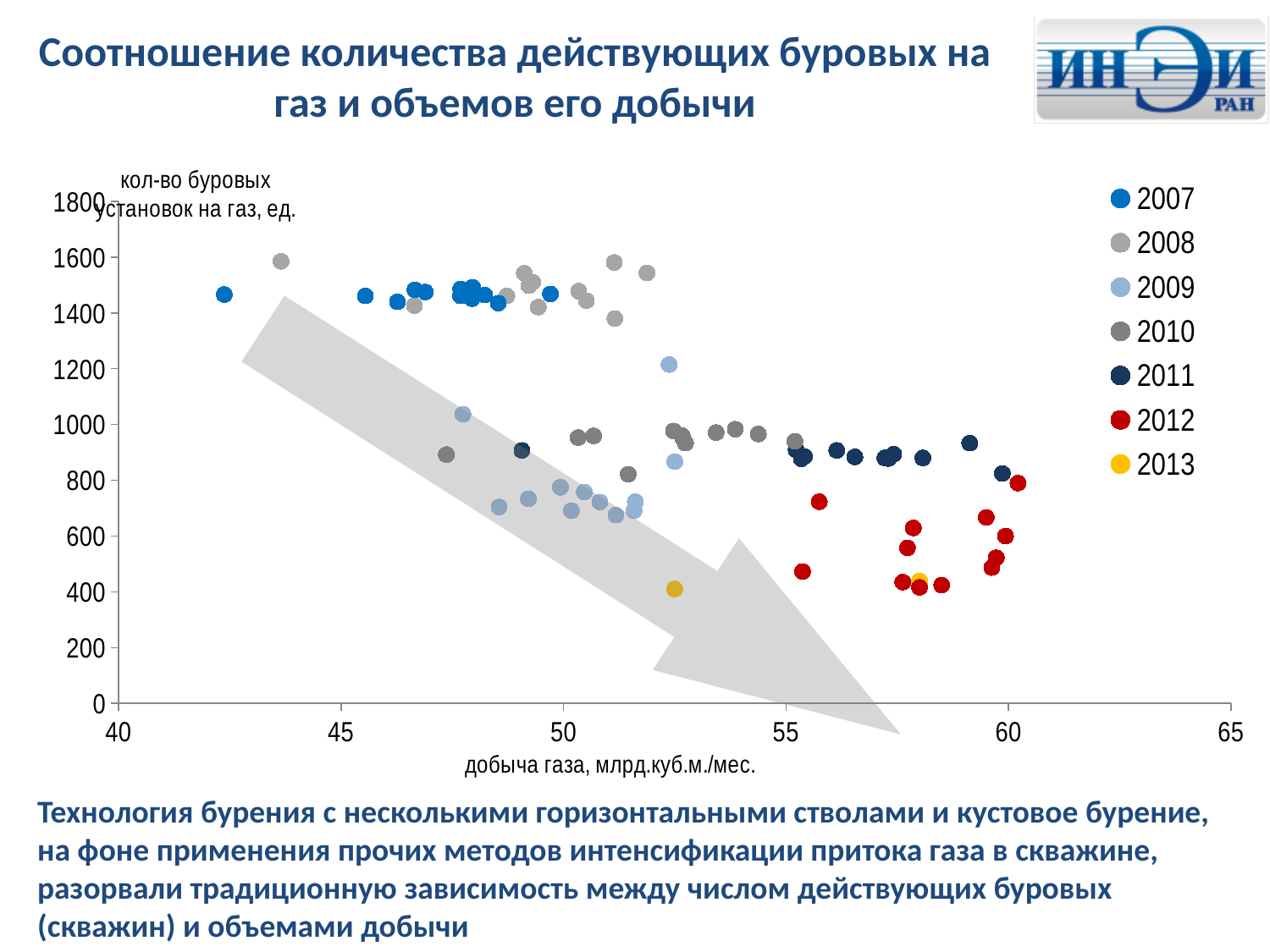
How many series does the legend list? 7 Are the values for the 2012 series greater or less than 1000 on the vertical axis? less Which series has the lowest number of drilling rigs, 2013 or 2011? 2013 Are the 2007 points located at gas production greater or less than 50 on the horizontal axis? less Are the 2012 points located at gas production greater or less than 55 on the horizontal axis? greater Which years are listed in the chart legend? 2007, 2008, 2009, 2010, 2011, 2012, 2013 What is the label of the horizontal axis? добыча газа, млрд.куб.м./мес. As gas production increases along the x axis, does the number of drilling rigs generally rise or fall? fall Which series has the highest number of drilling rigs, 2007 or 2012? 2007 What kind of chart is shown on the slide? scatter chart